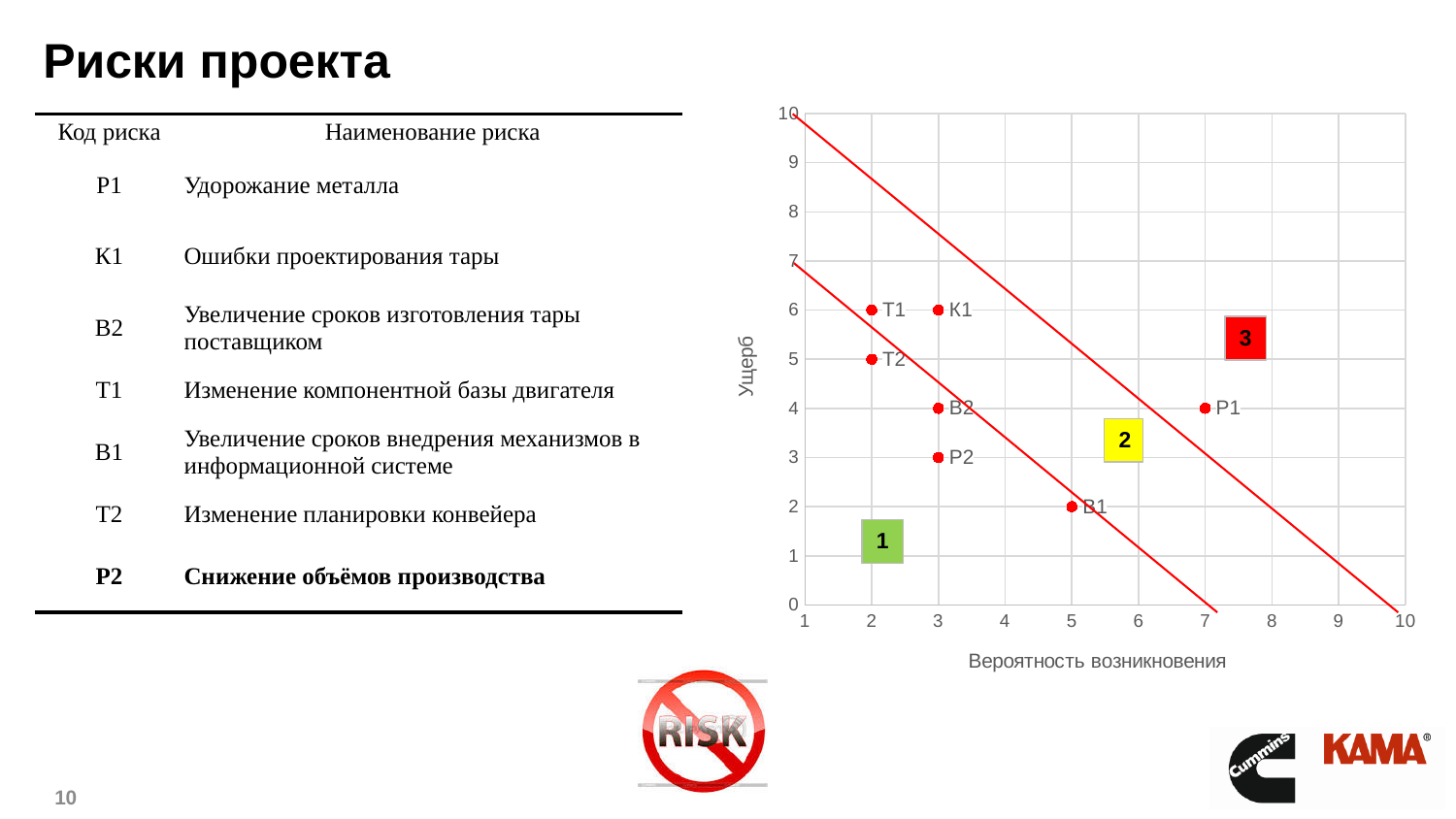
What is the Ущерб value for point T2? 5 Which risk point has the highest Вероятность возникновения? P1 What is the title of the vertical axis? Ущерб What is the Вероятность возникновения (probability) value for point P1? 7 Which risk point has the lowest Ущерб? B1 What is the Вероятность возникновения value for point B1? 5 What is the difference in Ущерб between T1 and B2? 2 How many risk points are plotted on the chart? 7 What is the Ущерб value for point B1? 2 Which has a higher Ущерб value, K1 or P2? K1 What is the Ущерб (damage) value for point P1? 4 What kind of chart is shown on the slide? scatter chart